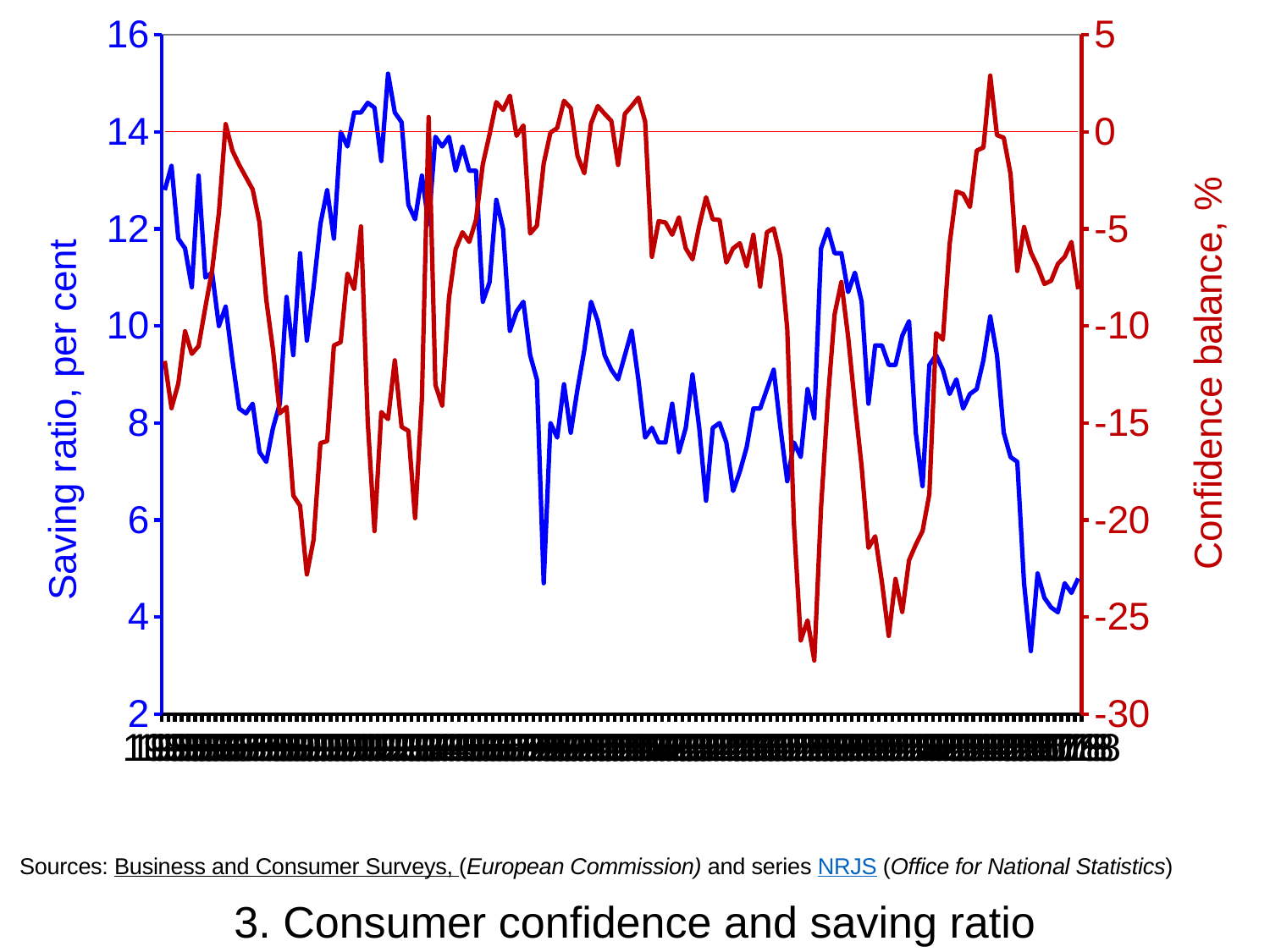
Is the highest value reached by the saving ratio line greater or less than 14? greater What kind of chart is shown on the slide? line chart Is the highest value reached by the confidence balance line greater or less than 0? greater How many data series are plotted on the chart? 2 What is the title of the chart? 3. Consumer confidence and saving ratio Is the saving ratio at the right-hand end of the chart greater or less than 6? less Comparing the start and the end of the chart, does the saving ratio line rise or fall overall? fall What colour is the line for the saving ratio? blue